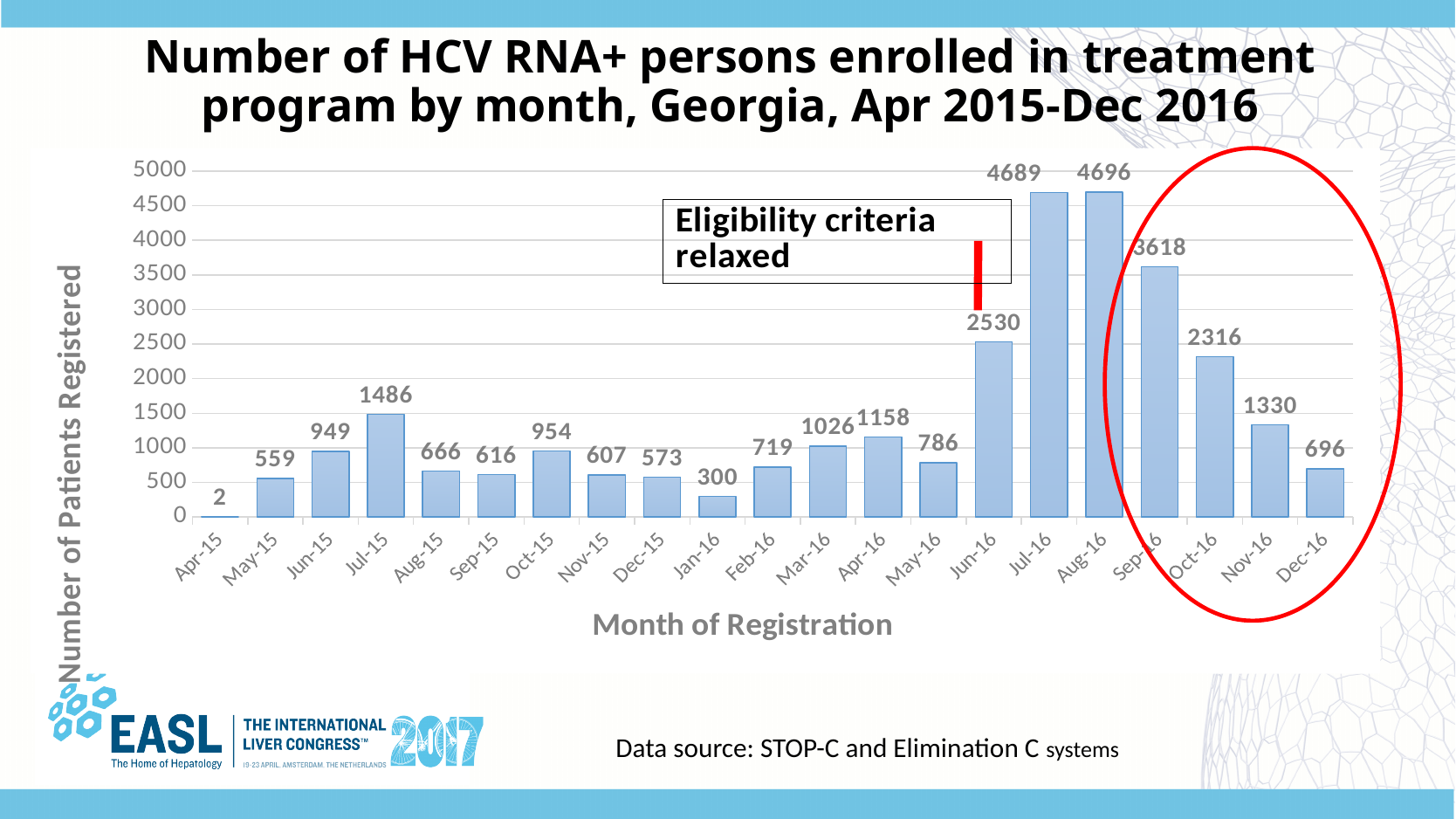
What is the number of patients registered for Jun-16? 2530 How many months are plotted on the x axis? 21 Do the values rise or fall from Aug-16 to Dec-16? Fall What value is shown for Sep-16? 3618 What is the difference between the values for Aug-16 and Jul-16? 7 Which month has the lowest number of patients registered? Apr-15 What type of chart is shown on the slide? Bar chart What is the label of the x axis? Month of Registration What is the difference between the values for Sep-16 and Oct-16? 1302 Which month has a larger value, Mar-16 or Feb-16? Mar-16 Which month has the highest number of patients registered? Aug-16 How many patients were registered in Jul-15? 1486